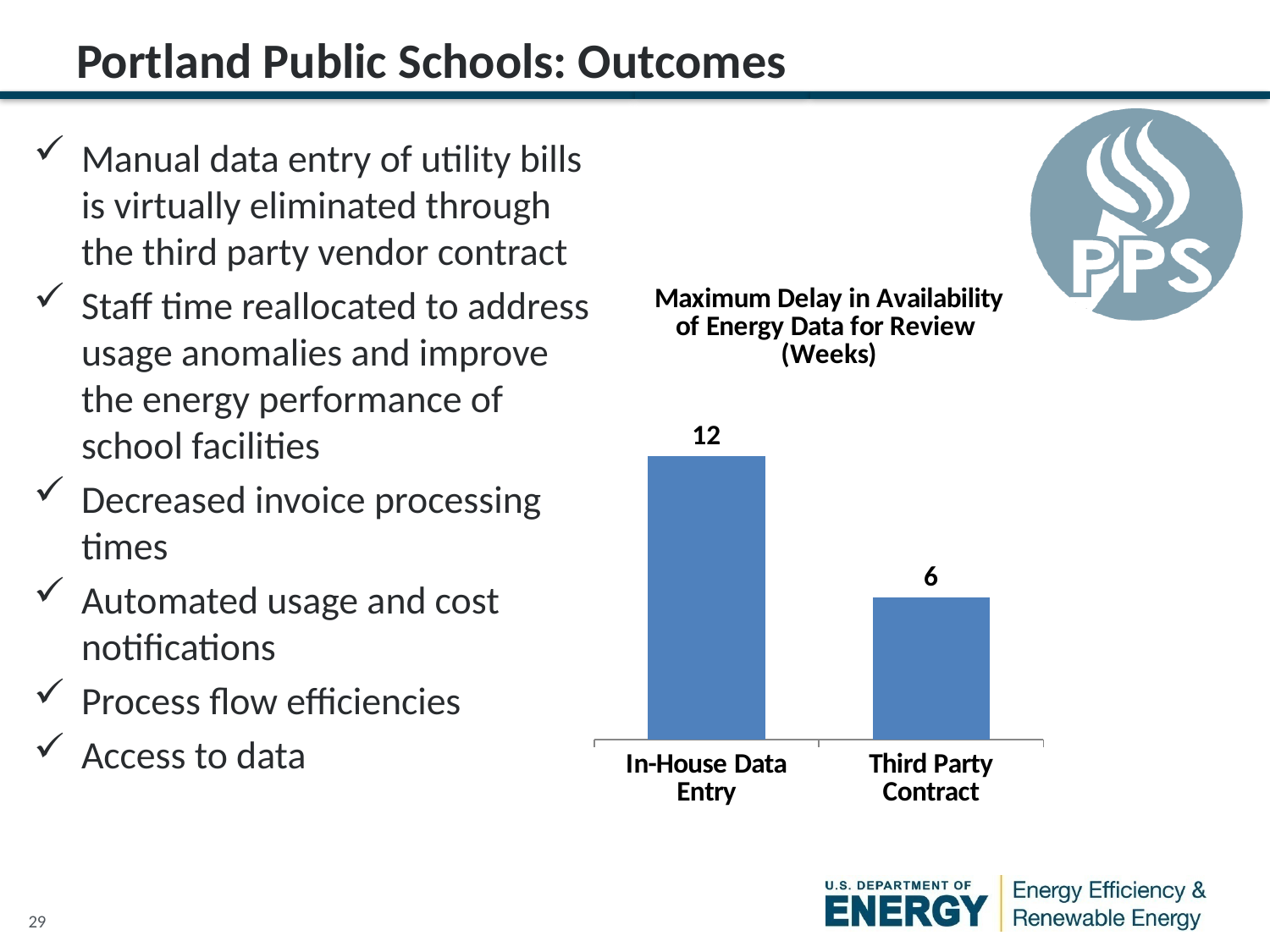
Which category has the lowest value? Third Party Contract What kind of chart is shown on the slide? Bar chart What is the value for Third Party Contract? 6 Do the values fall or rise from In-House Data Entry to Third Party Contract? Fall What is the difference between the values for In-House Data Entry and Third Party Contract? 6 Which category has the highest value? In-House Data Entry What is the title of the chart? Maximum Delay in Availability of Energy Data for Review (Weeks) How many categories are shown in the chart? 2 Which is larger, the value for In-House Data Entry or the value for Third Party Contract? In-House Data Entry What is the value for In-House Data Entry? 12 In what unit are the chart's values expressed? Weeks